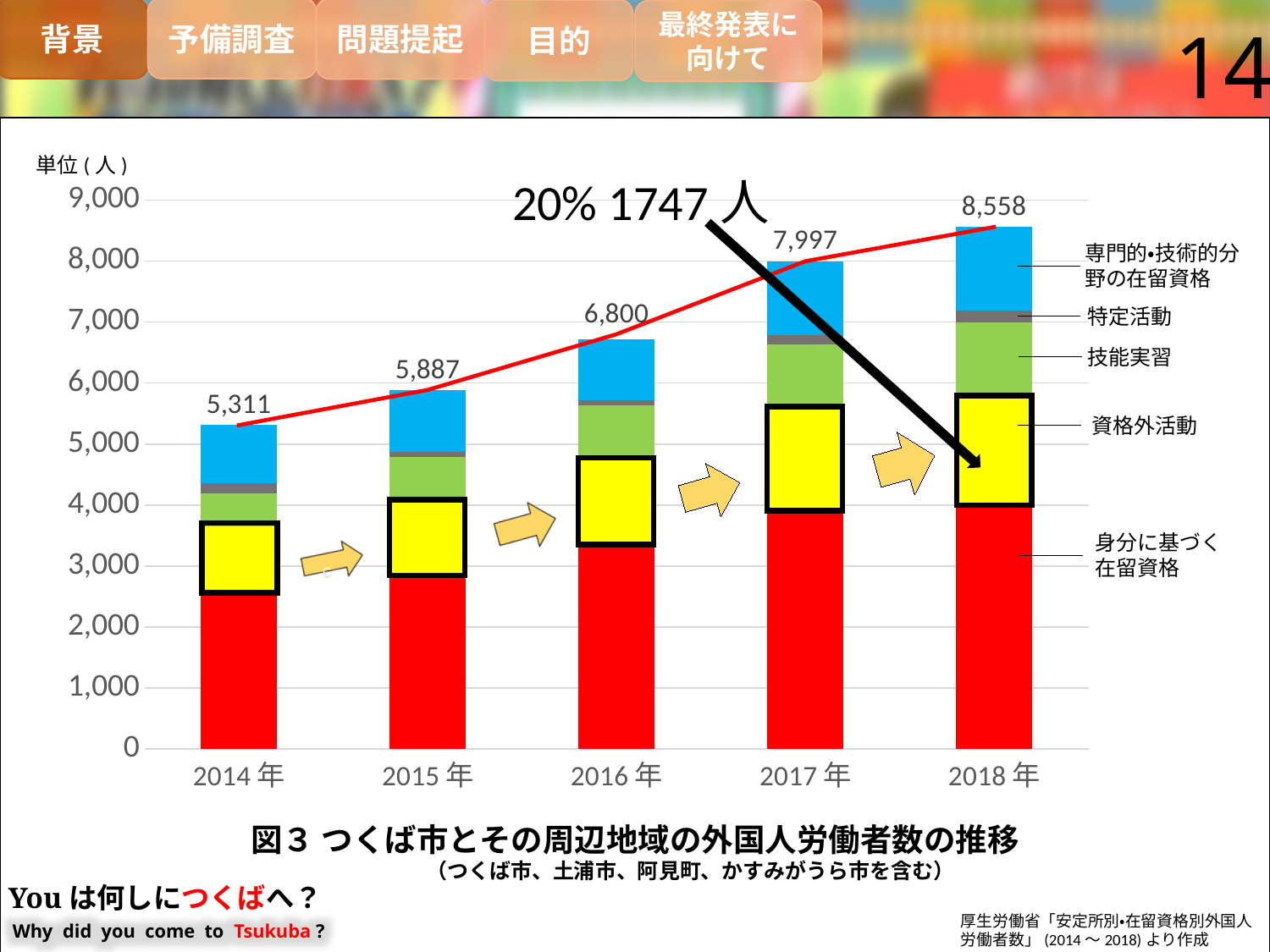
What is the total number of foreign workers shown for 2014年? 5,311 Which year has the highest total number of foreign workers? 2018年 Do the total values rise or fall from 2014年 to 2018年? rise Is the value of the 身分に基づく在留資格 segment for 2014年 greater or less than 3,000? less How many series (residence status categories) are labeled on the right of the chart? 5 What is the difference between the total for 2018年 and the total for 2014年? 3,247 Which year has the lowest total number of foreign workers? 2014年 What is the total value labeled above the bar for 2016年? 6,800 What is the total value labeled above the bar for 2017年? 7,997 How many years are shown on the x axis? 5 Which is larger, the total for 2015年 or the total for 2016年? 2016年 What is the difference between the total for 2017年 and the total for 2016年? 1,197